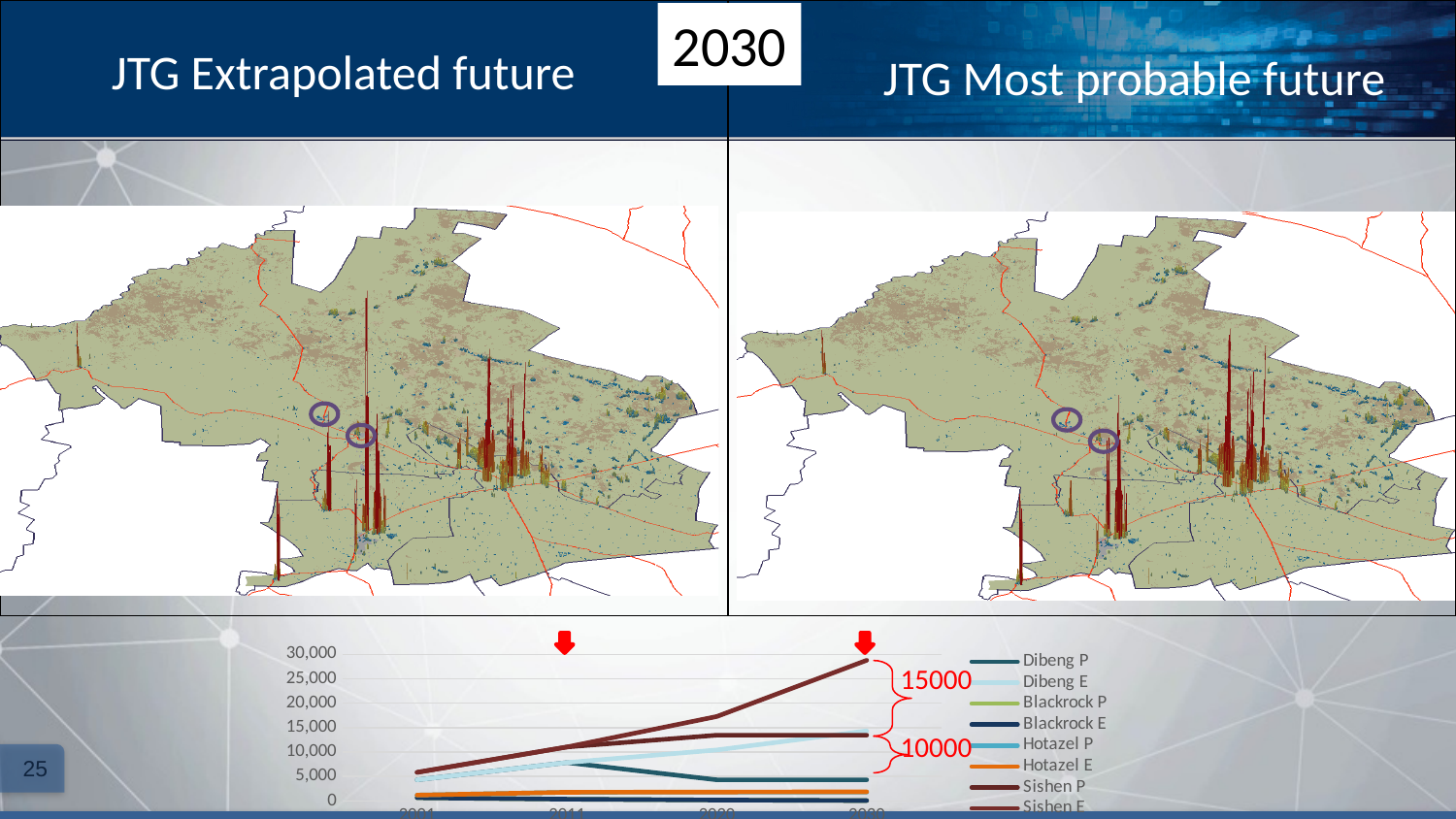
Which series is listed last in the legend of the line chart? Sishen E What kind of chart is shown at the bottom of the slide? line chart How many series does the legend of the line chart list? 8 Which series is listed first in the legend of the line chart? Dibeng P What number is annotated next to the upper brace on the right side of the line chart? 15000 Is the value for Sishen E at the right end of the line chart greater or less than 20,000? greater Does the Sishen E line rise or fall from left to right across the chart? rise Is the value for Sishen P at the right end of the line chart greater or less than 20,000? less At the right end of the line chart, which is larger: Sishen E or Sishen P? Sishen E Which series has the highest value at the right end of the line chart? Sishen E